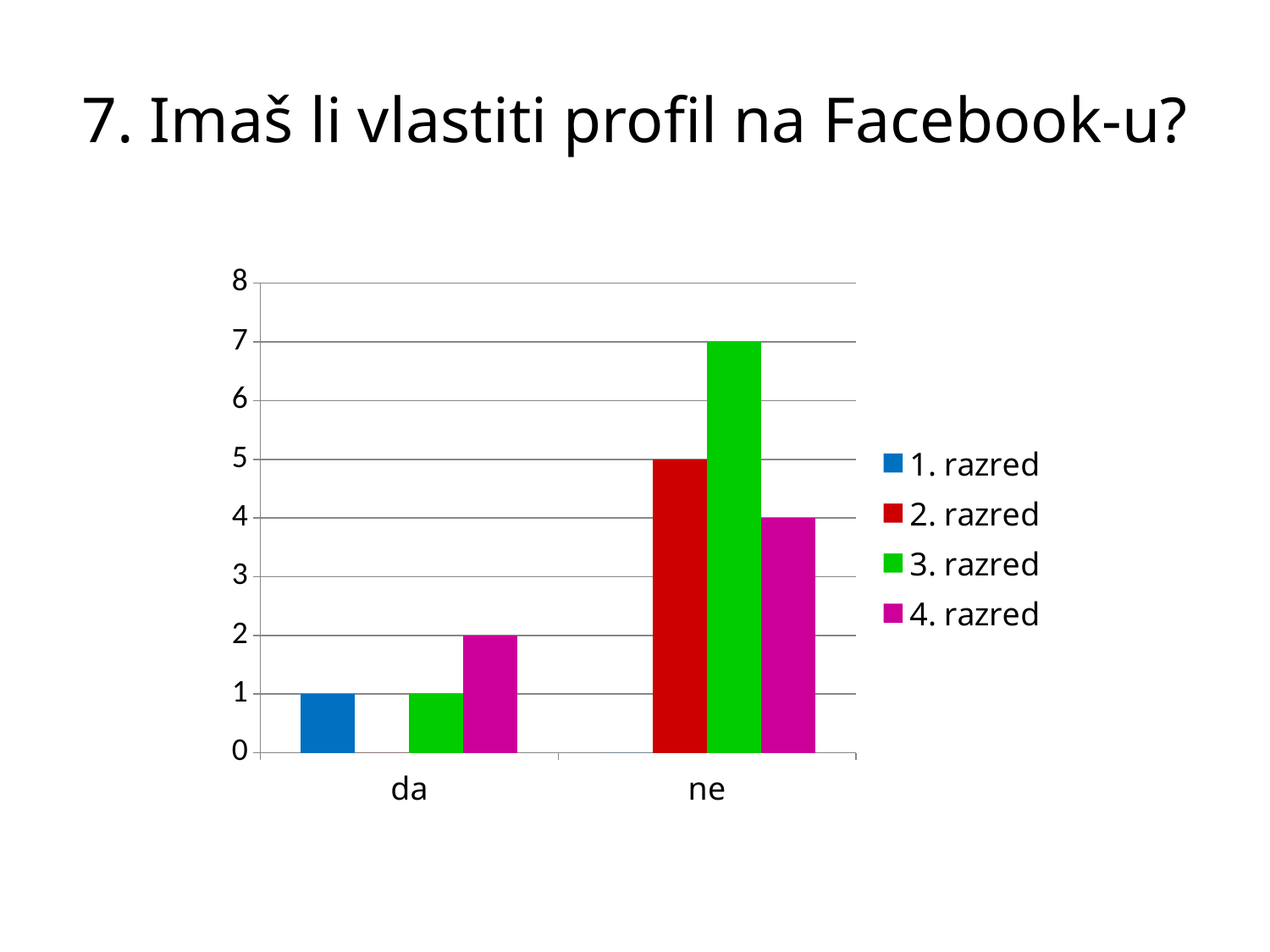
How many categories are shown on the x axis? 2 Which series has the highest value in the "ne" category? 3. razred What kind of chart is shown on the slide? bar chart Which is larger: the 2. razred value for "ne" or the 4. razred value for "ne"? 2. razred What is the value for 4. razred in the "da" category? 2 How many series does the legend list? 4 What is the value for 3. razred in the "ne" category? 7 Which series has the highest value in the "da" category? 4. razred What is the value for 2. razred in the "ne" category? 5 What is the difference between the 3. razred and 4. razred values in the "ne" category? 3 What is the value for 1. razred in the "da" category? 1 What is the title of the slide? 7. Imaš li vlastiti profil na Facebook-u?